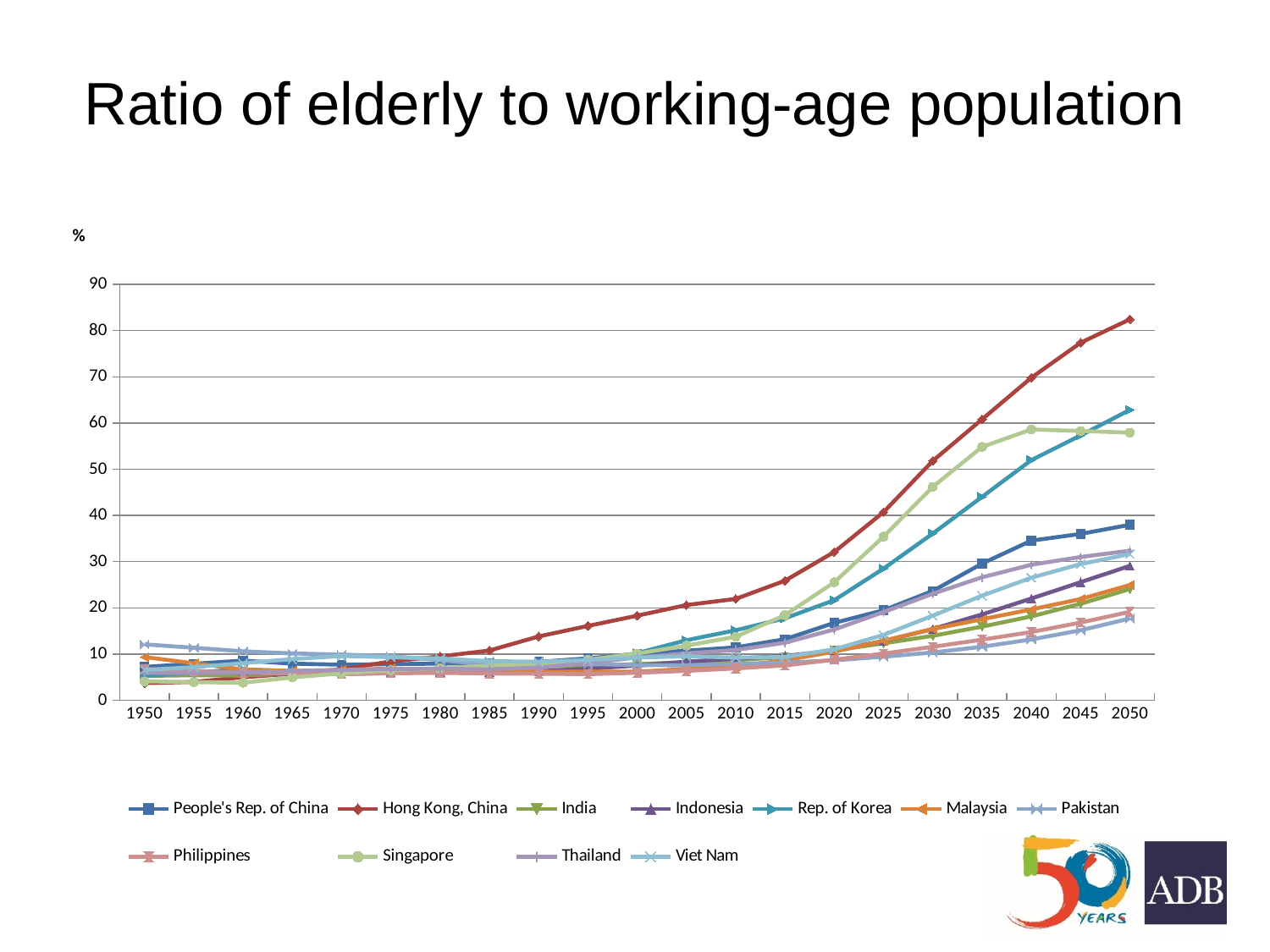
How many series does the legend list? 11 How many years are marked along the x axis? 21 Is the value for People's Rep. of China in 2050 greater or less than 30? greater Is the value for Hong Kong, China in 2050 greater or less than 80? greater Is the value for Singapore in 2050 greater or less than 50? greater What kind of chart is shown on the slide? line chart Which economy has the highest ratio in 2000? Hong Kong, China In 2040, which is higher: Singapore or Rep. of Korea? Singapore Does the line for Hong Kong, China rise or fall from 2000 to 2050? rises Which economy has the highest ratio in 2050? Hong Kong, China